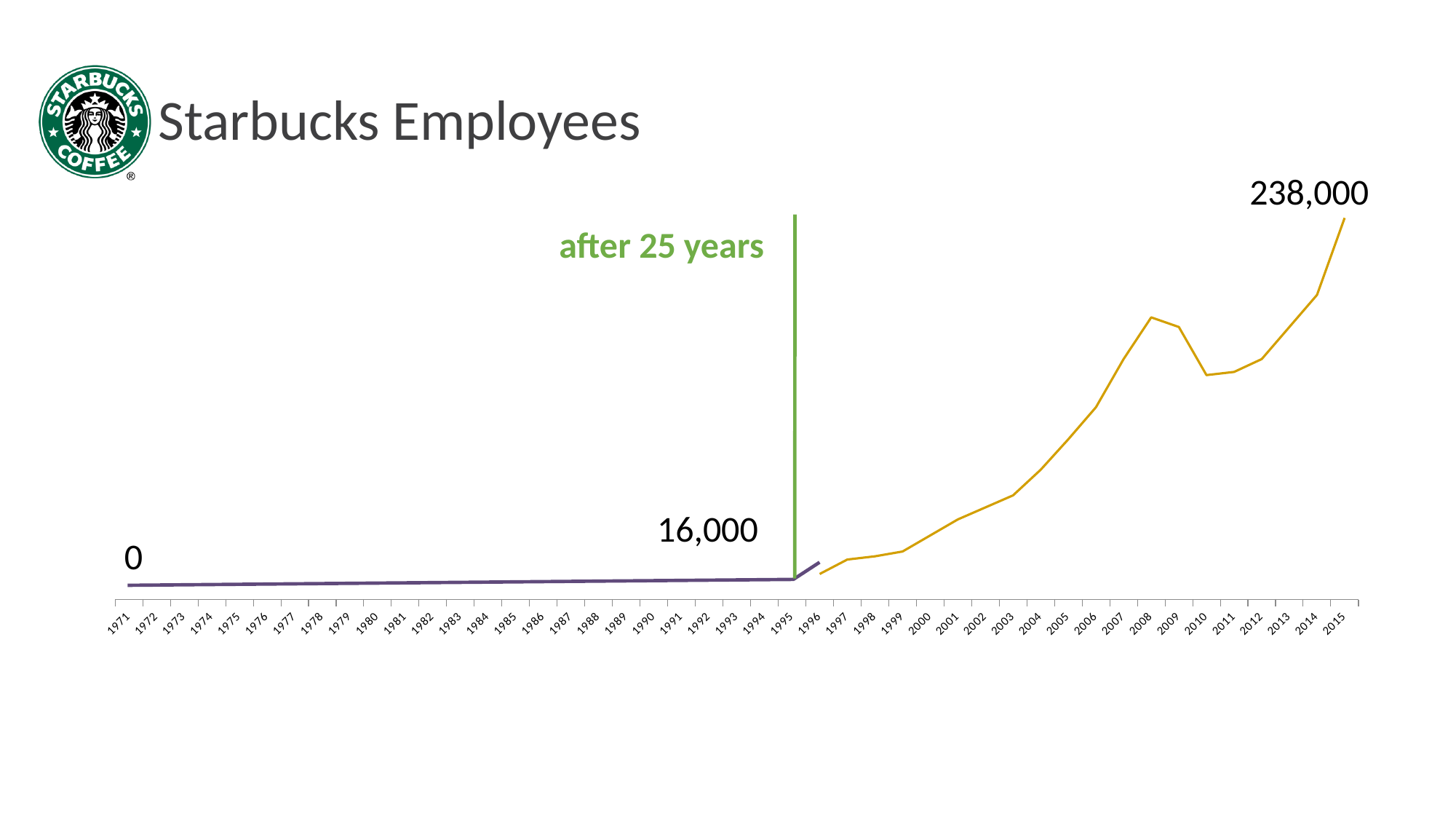
Which is larger, the value for 2008 or the value for 2010? 2008 Overall, do the values rise or fall from 1971 to 2015? rise Which year has the lowest value on the chart? 1971 What value is labelled for 2015? 238,000 What kind of chart is shown on the slide? line chart What is the title of the chart? Starbucks Employees Which year has the highest value on the chart? 2015 What does the green annotation next to the vertical line say? after 25 years What value is labelled for 1971? 0